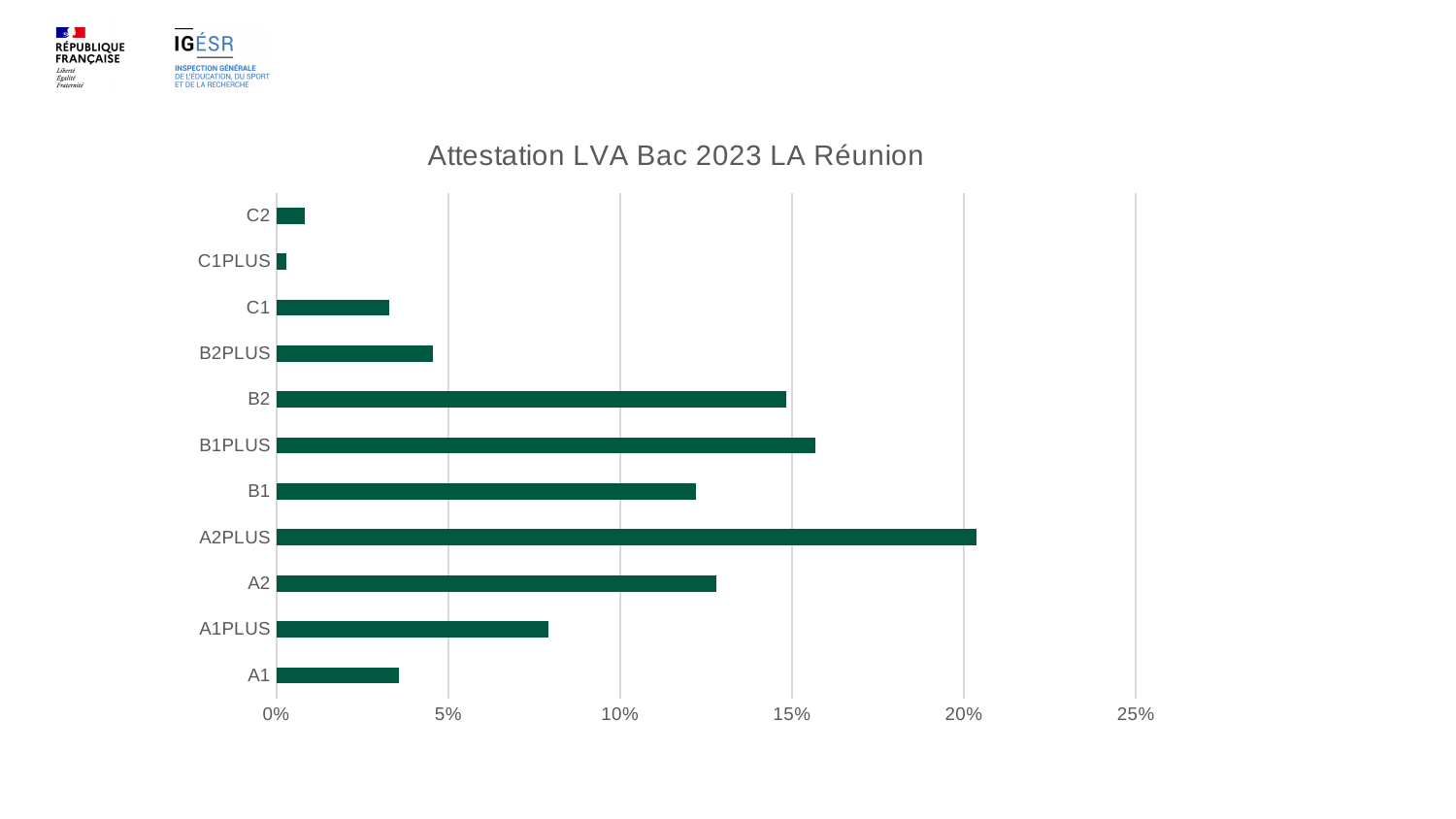
Is the value for A2PLUS greater or less than 15%? greater Which has the larger value, B1PLUS or B1? B1PLUS Which has the larger value, A1PLUS or A1? A1PLUS What type of chart is shown on the slide? bar chart Is the value for B1PLUS greater or less than 15%? greater Which level has the lowest value in the chart? C1PLUS Which level has the highest value in the chart? A2PLUS Is the value for C1 greater or less than 5%? less How many categories (levels) are plotted in the chart? 11 What is the title of the chart? Attestation LVA Bac 2023 LA Réunion